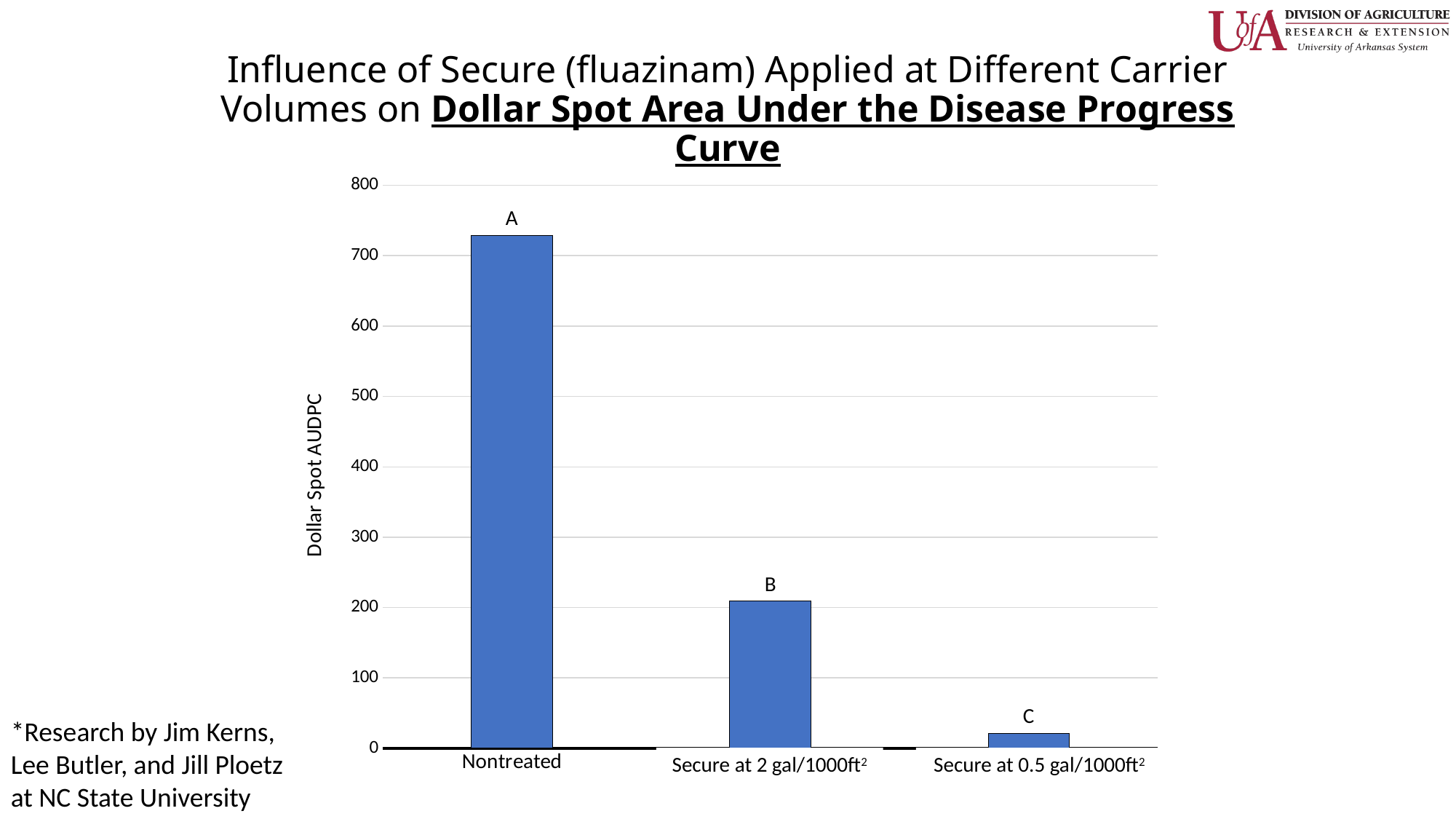
Do the bar values rise or fall moving from left to right along the x axis? fall Which treatment has the lowest Dollar Spot AUDPC? Secure at 0.5 gal/1000ft² Is the Dollar Spot AUDPC for Nontreated greater or less than 700? greater How many treatment categories are plotted on the x axis? 3 Which has a larger Dollar Spot AUDPC, Secure at 2 gal/1000ft² or Secure at 0.5 gal/1000ft²? Secure at 2 gal/1000ft² What letter is printed above the Nontreated bar? A Is the Dollar Spot AUDPC for Secure at 0.5 gal/1000ft² greater or less than 100? less What is the maximum value shown on the y axis? 800 Which treatment has the highest Dollar Spot AUDPC? Nontreated What kind of chart is shown on the slide? bar chart What is the label on the y axis of the chart? Dollar Spot AUDPC